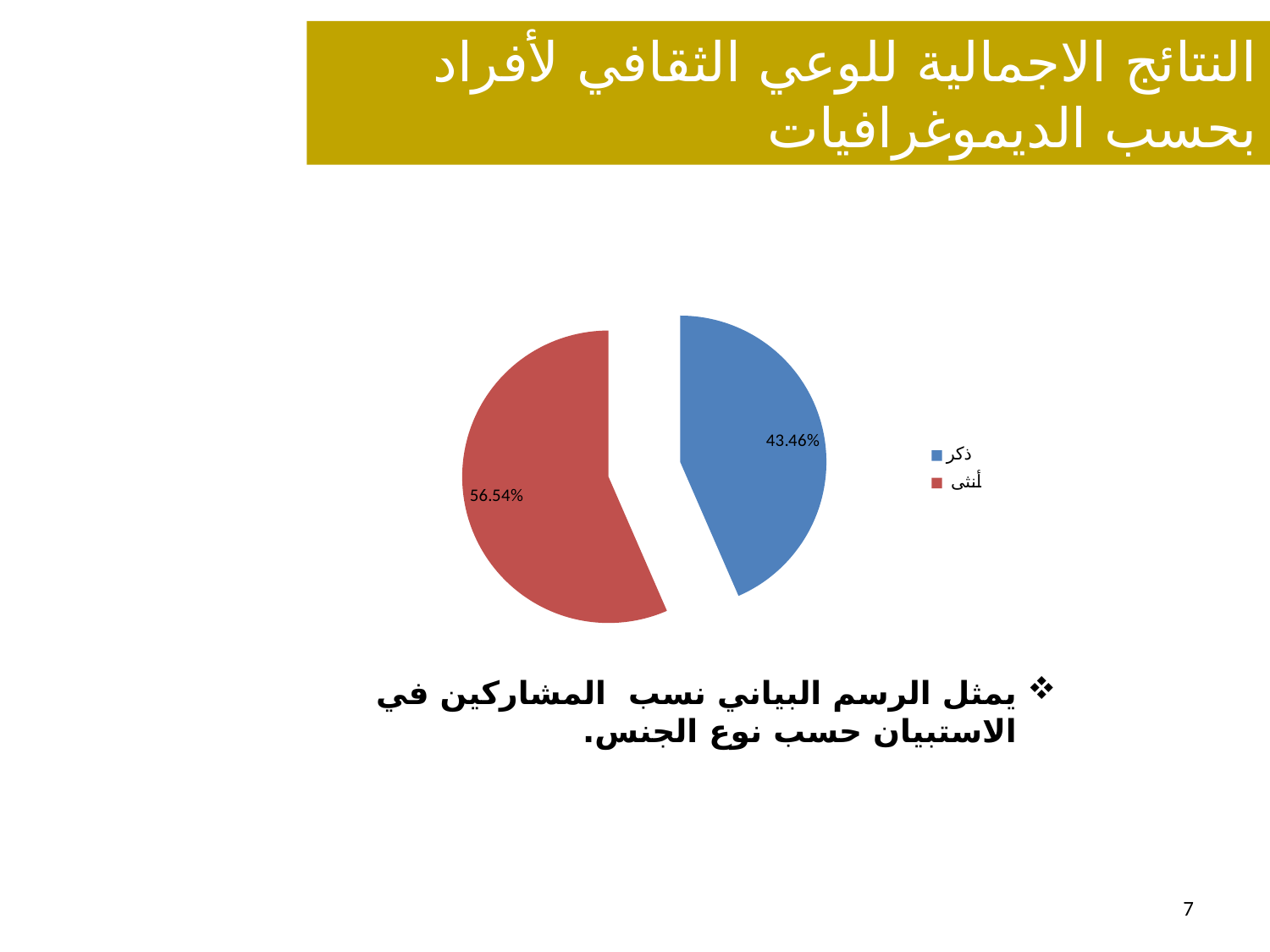
What is the value shown for ذكر in the pie chart? 43.46% How many entries does the legend of the pie chart list? 2 What colour is the ذكر slice in the pie chart? blue How many slices does the pie chart have? 2 What is the value shown for أنثى in the pie chart? 56.54% What kind of chart is shown on the slide? pie chart What share of the pie does the ذكر slice represent? 43.46% What colour is the أنثى slice in the pie chart? red Which category has the smallest slice in the pie chart? ذكر What is the difference between the أنثى and ذكر slices in the pie chart? 13.08% Which category has the largest slice in the pie chart? أنثى Which is larger in the pie chart, ذكر or أنثى? أنثى